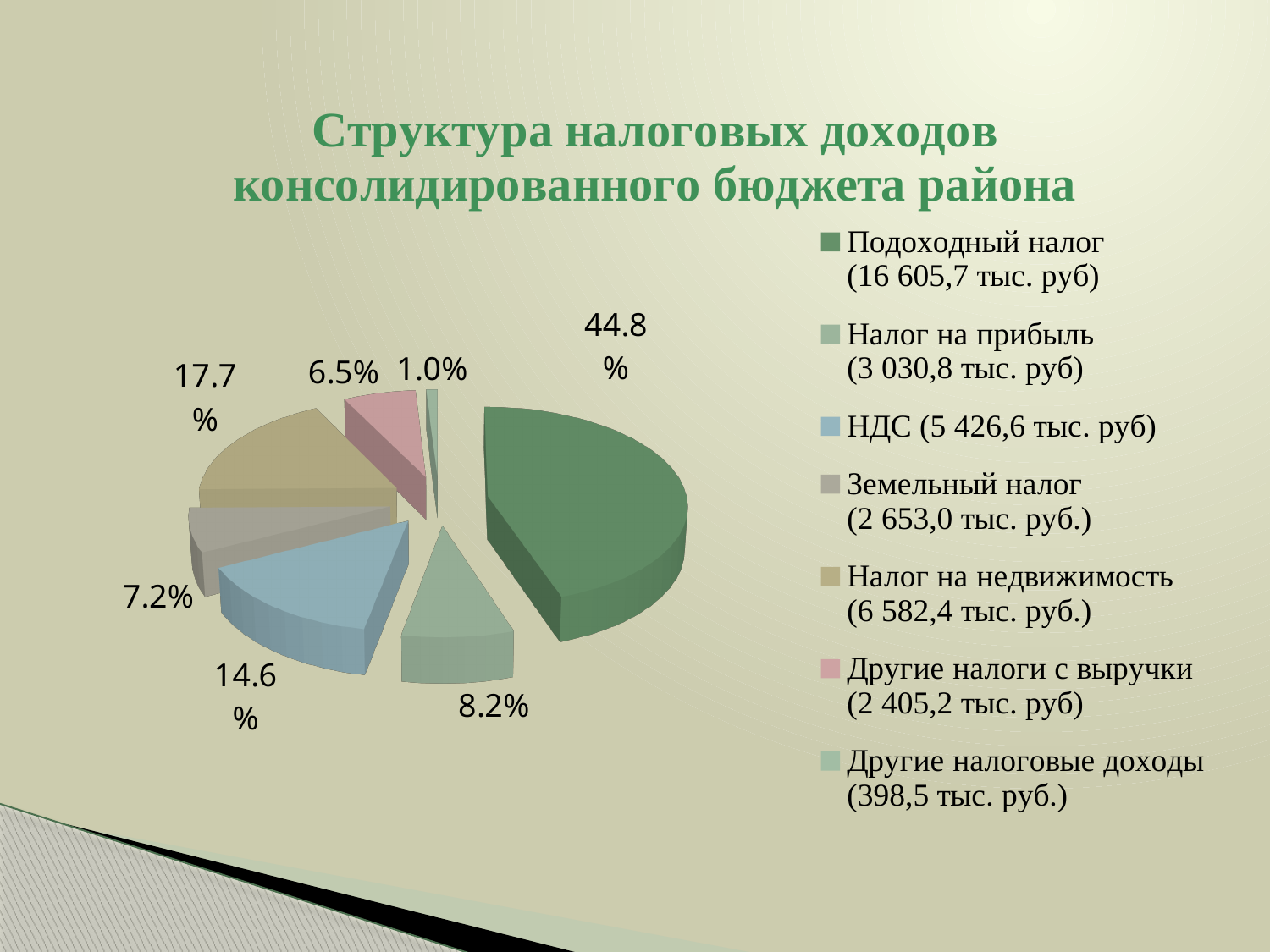
What amount in тыс. руб is shown in the legend for НДС? 5 426,6 тыс. руб What share of the pie does Подоходный налог have? 44.8% What share of the pie does Земельный налог have? 7.2% What share of the pie does Налог на недвижимость have? 17.7% What is the difference in percentage points between the shares of Налог на недвижимость and НДС? 3.1 Which category has the largest slice of the pie? Подоходный налог How many slices does the pie chart have? 7 Which has a larger share, Налог на прибыль or Другие налоги с выручки? Налог на прибыль Which category has the smallest slice of the pie? Другие налоговые доходы What kind of chart is shown on the slide? pie chart